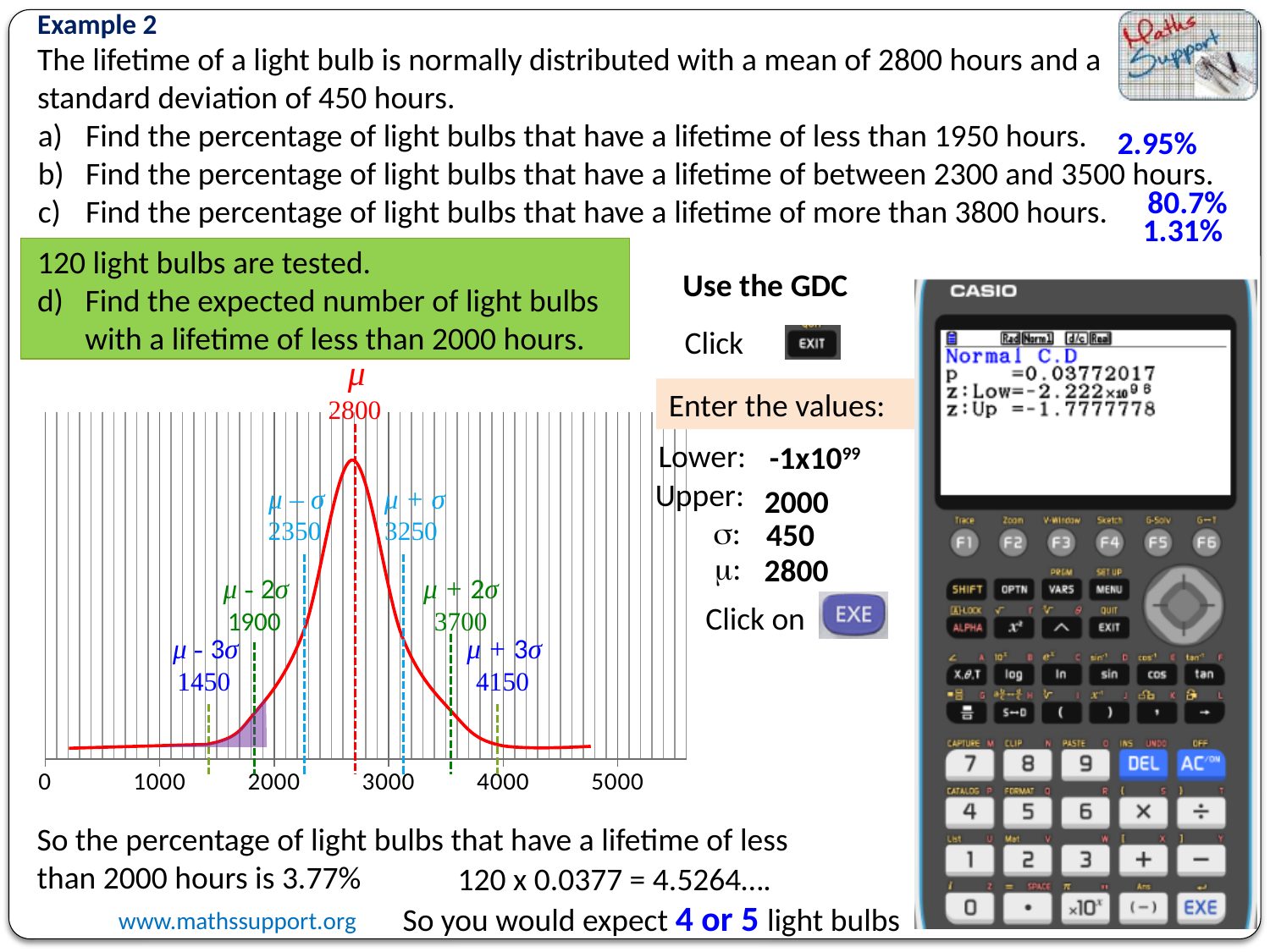
Does the curve rise or fall along the x axis between 1000 and 2800? rise What value is labelled at μ − σ on the chart? 2350 What is the difference between the values labelled at μ + σ and μ − σ on the chart? 900 What is the difference between the values labelled at μ + 3σ and μ − 3σ on the chart? 2700 What value is labelled at μ + 3σ on the chart? 4150 What value is labelled at the mean μ on the chart? 2800 What value is labelled at μ + σ on the chart? 3250 What colour is the normal distribution curve on the chart? red What value is labelled at μ − 2σ on the chart? 1900 How many labelled tick values are shown on the x axis of the chart? 6 Which is larger on the chart, the value at μ + 2σ or the value at μ + σ? μ + 2σ What kind of chart is shown on the slide? line chart